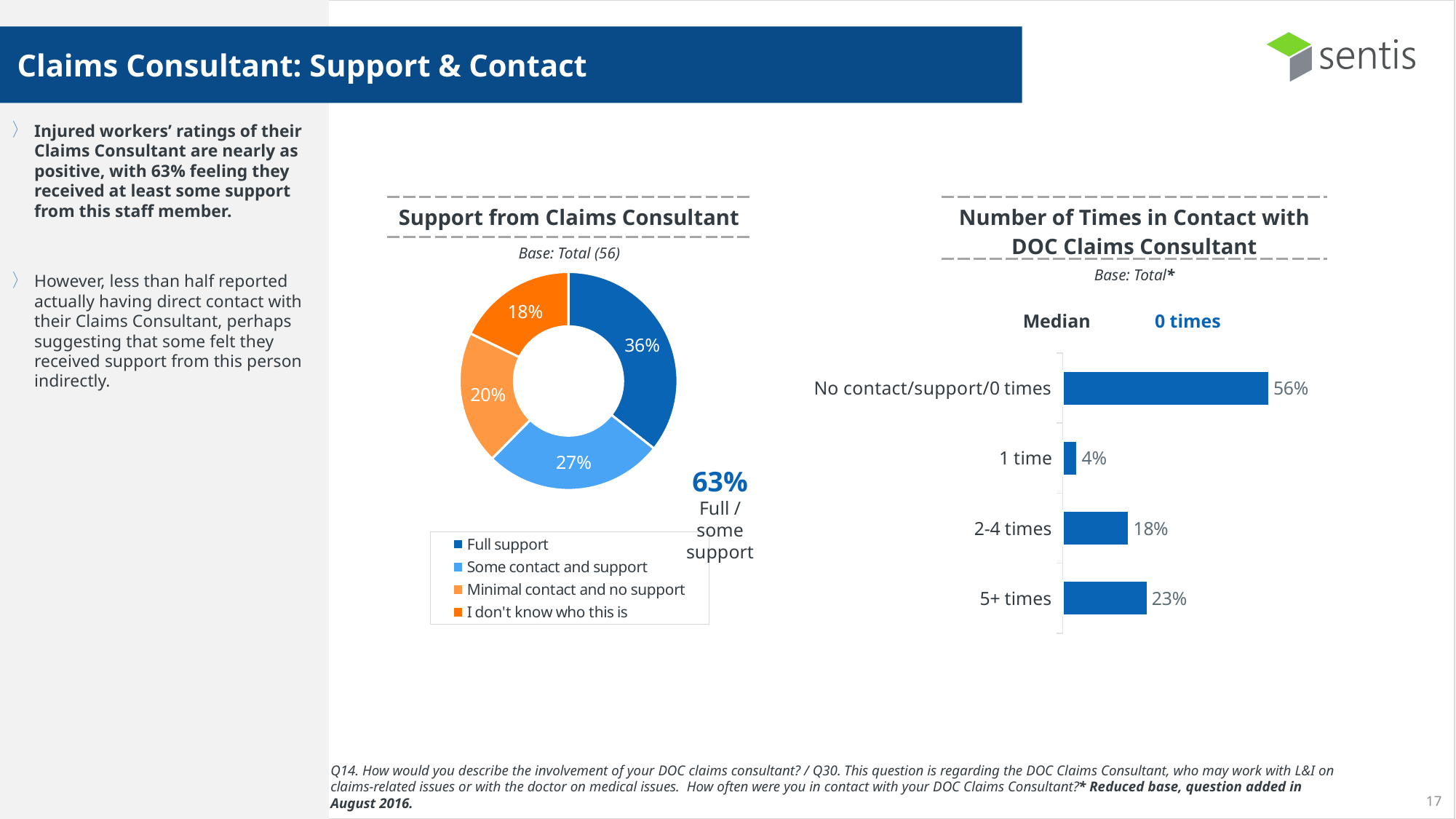
In the 'Number of Times in Contact with DOC Claims Consultant' chart, what is the value for '5+ times'? 23% In the 'Number of Times in Contact with DOC Claims Consultant' chart, which category has the highest value? No contact/support/0 times In the 'Support from Claims Consultant' chart, what percentage is shown for 'I don't know who this is'? 18% What type of chart is 'Number of Times in Contact with DOC Claims Consultant'? Bar chart In the 'Number of Times in Contact with DOC Claims Consultant' chart, which category has the lowest value? 1 time In the 'Support from Claims Consultant' chart, which category has the largest share? Full support How many categories does the legend of the 'Support from Claims Consultant' chart list? 4 What type of chart is 'Support from Claims Consultant'? Doughnut chart In the 'Support from Claims Consultant' chart, what percentage is shown for 'Full support'? 36% In the 'Support from Claims Consultant' chart, which category has the smallest share? I don't know who this is In the 'Number of Times in Contact with DOC Claims Consultant' chart, what is the difference between 'No contact/support/0 times' and '2-4 times'? 38% In the 'Support from Claims Consultant' chart, what is the difference between 'Some contact and support' and 'Minimal contact and no support'? 7%